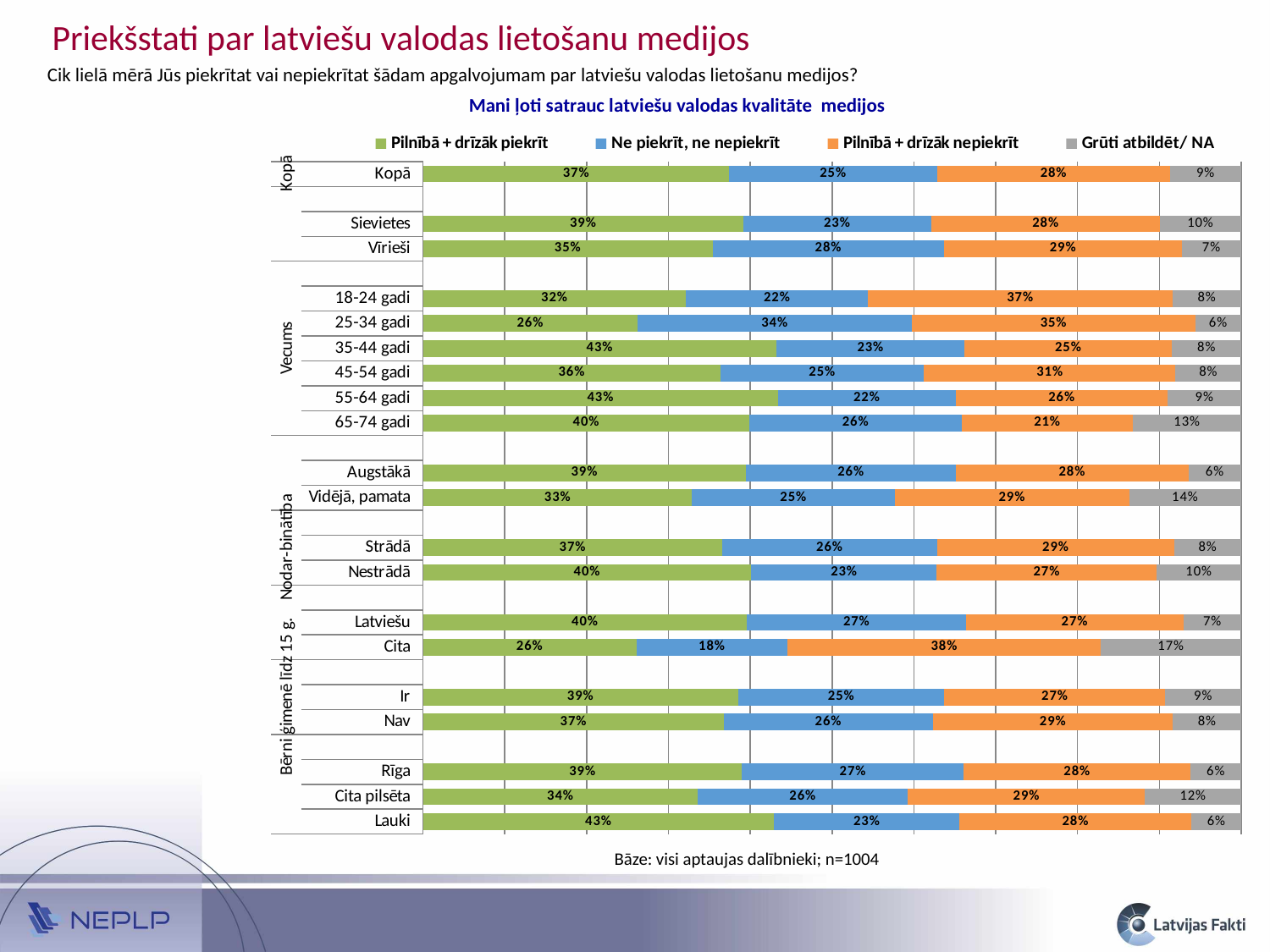
What is the 'Ne piekrīt, ne nepiekrīt' value for the '25-34 gadi' group? 34% How many groups (bars) are plotted in the chart? 20 Which group has the highest 'Pilnībā + drīzāk nepiekrīt' value? Cita What is the 'Grūti atbildēt/ NA' value for the 'Cita' group? 17% What type of chart is shown on the slide? Stacked bar chart What percentage of the 'Kopā' group falls in the 'Pilnībā + drīzāk piekrīt' category? 37% Which group has the lowest 'Ne piekrīt, ne nepiekrīt' value? Cita Which group has the highest 'Grūti atbildēt/ NA' value? Cita How many series does the legend list? 4 Which has a larger 'Pilnībā + drīzāk piekrīt' value, 'Sievietes' or 'Vīrieši'? Sievietes What is the difference in the 'Pilnībā + drīzāk nepiekrīt' value between 'Cita' and 'Latviešu'? 11 percentage points What is the total of the four segments for the 'Lauki' bar? 100%